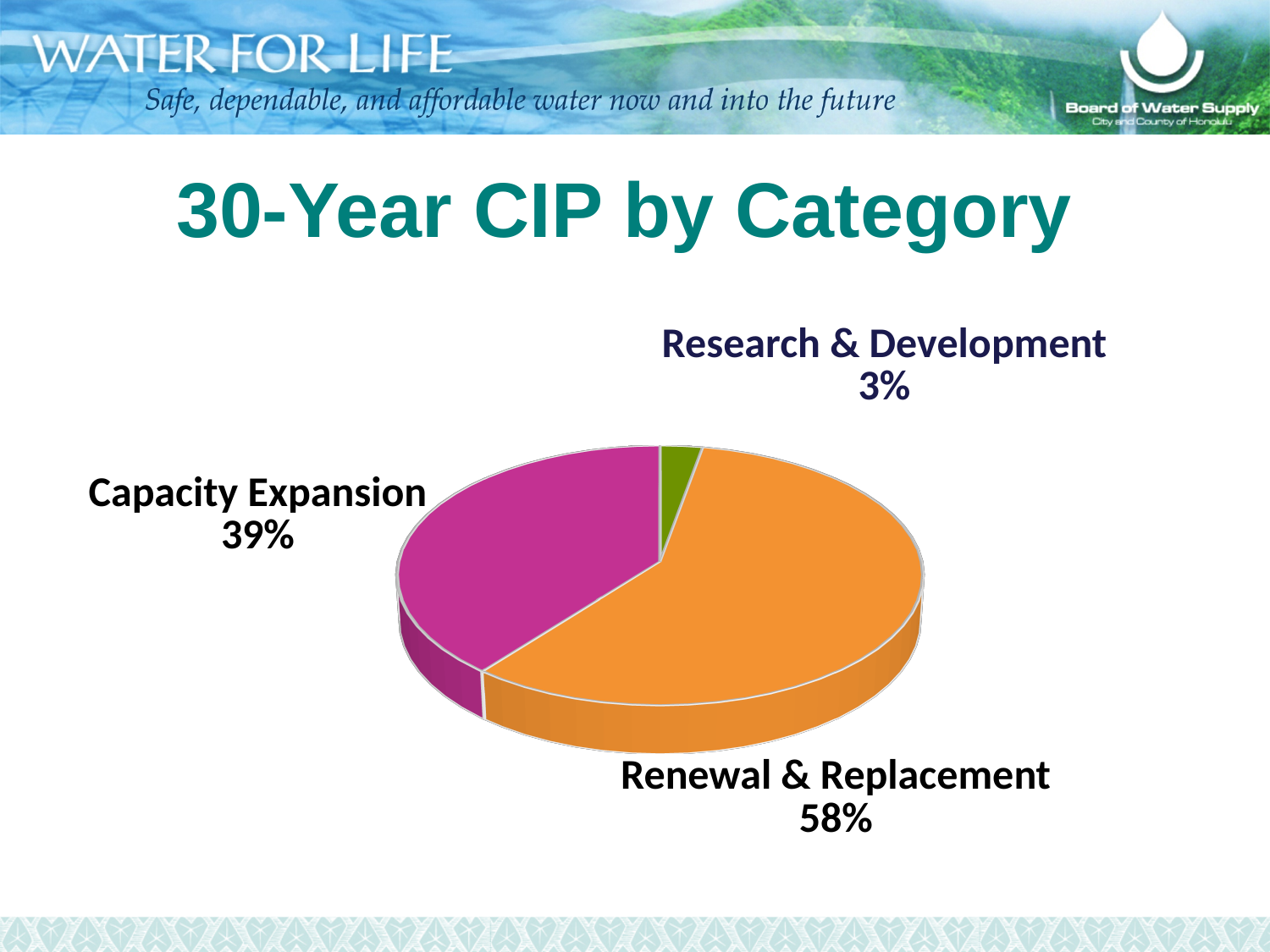
What share of the 30-Year CIP does Research & Development account for? 3% How many categories are shown in the pie chart? 3 What share of the 30-Year CIP does Capacity Expansion account for? 39% How many percentage points larger is the Capacity Expansion share than the Research & Development share? 36 Which category has the largest share of the 30-Year CIP? Renewal & Replacement Which is larger, the share for Capacity Expansion or the share for Research & Development? Capacity Expansion What kind of chart is shown on the slide? Pie chart What colour is the Capacity Expansion slice of the pie chart? Magenta What is the title of the chart on the slide? 30-Year CIP by Category What share of the 30-Year CIP does Renewal & Replacement account for? 58% How many percentage points larger is the Renewal & Replacement share than the Capacity Expansion share? 19 Which category has the smallest share of the 30-Year CIP? Research & Development